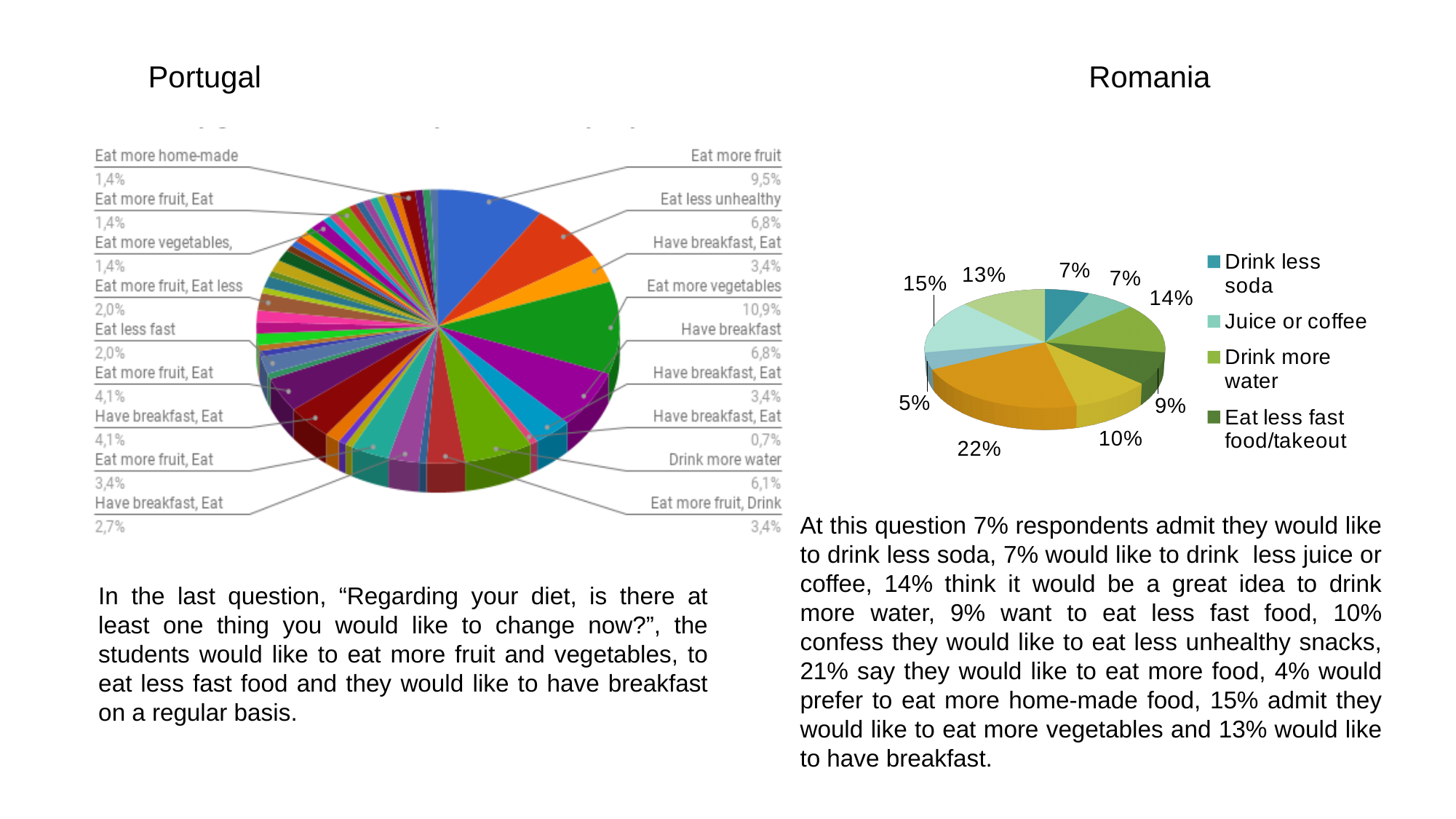
On the Portugal chart, what percentage is shown for "Eat more vegetables"? 10,9% On the Romania chart, what is the percentage of the smallest slice? 5% On the Portugal chart, what percentage is shown for "Drink more water"? 6,1% On the Portugal chart, what is the difference between the shares for "Eat more vegetables" and "Eat more fruit"? 1,4% On the Romania chart, what percentage is shown for "Drink less soda"? 7% On the Romania chart, what percentage is shown for "Eat less fast food/takeout"? 9% What kind of chart is the Portugal chart? Pie chart On the Portugal chart, what percentage is shown for "Eat more fruit"? 9,5% How many entries does the legend of the Romania chart list? 4 On the Portugal chart, which has the larger share, "Eat more fruit" or "Eat less unhealthy"? Eat more fruit On the Romania chart, what percentage is shown for "Drink more water"? 14% On the Romania chart, what is the percentage of the largest slice? 22%